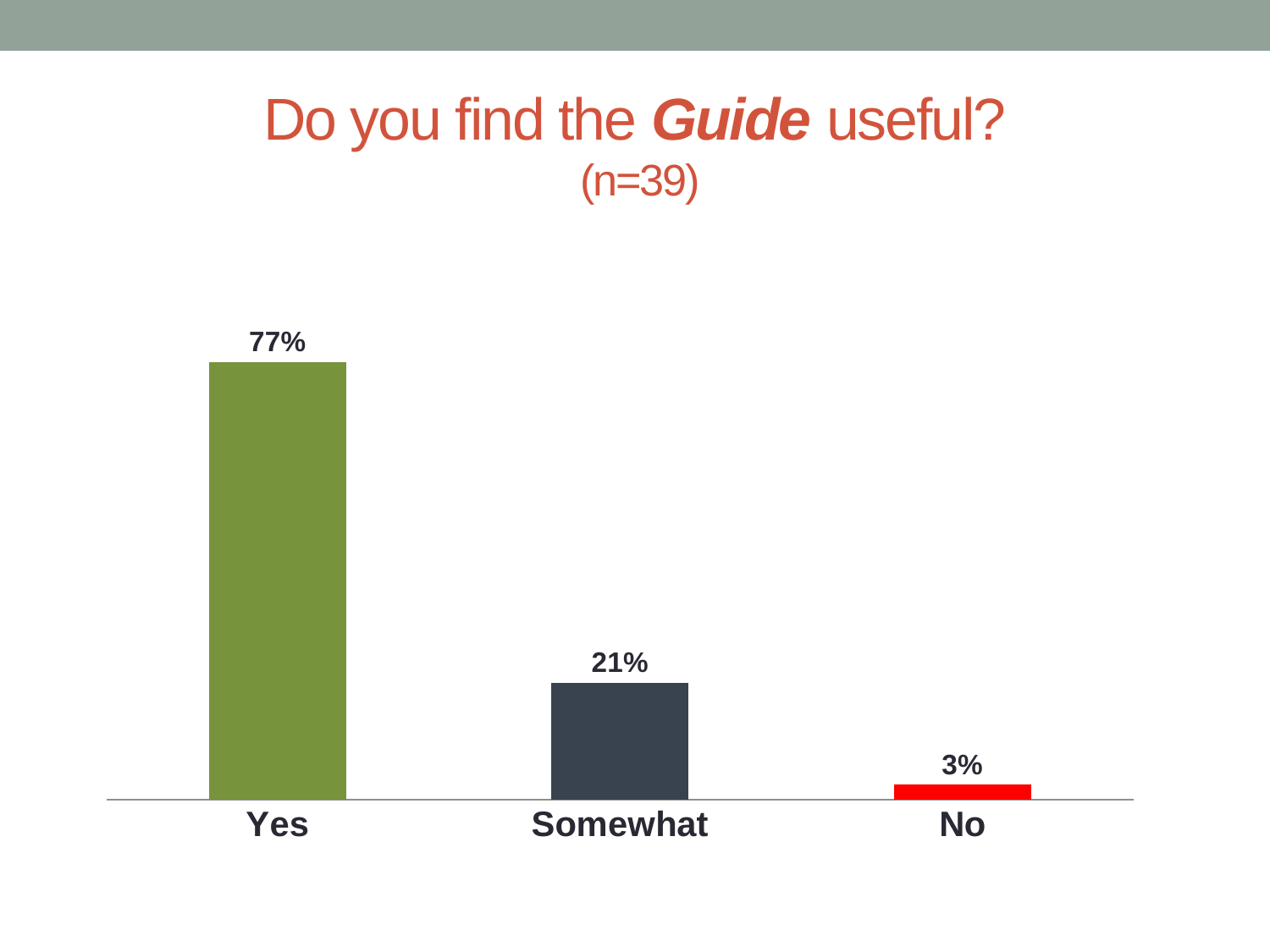
What percentage of respondents answered "No"? 3% How many response categories are shown in the chart? 3 What kind of chart is shown on the slide? Bar chart What is the difference between the "Somewhat" and "No" percentages? 18% Which is larger, the value for "Somewhat" or the value for "No"? Somewhat What is the sample size (n) stated in the chart title? 39 What percentage of respondents answered "Somewhat"? 21% Do the values rise or fall from left to right across the categories? Fall What percentage of respondents answered "Yes"? 77% Which response category has the highest value? Yes What is the difference between the "Yes" and "Somewhat" percentages? 56% Which response category has the lowest value? No